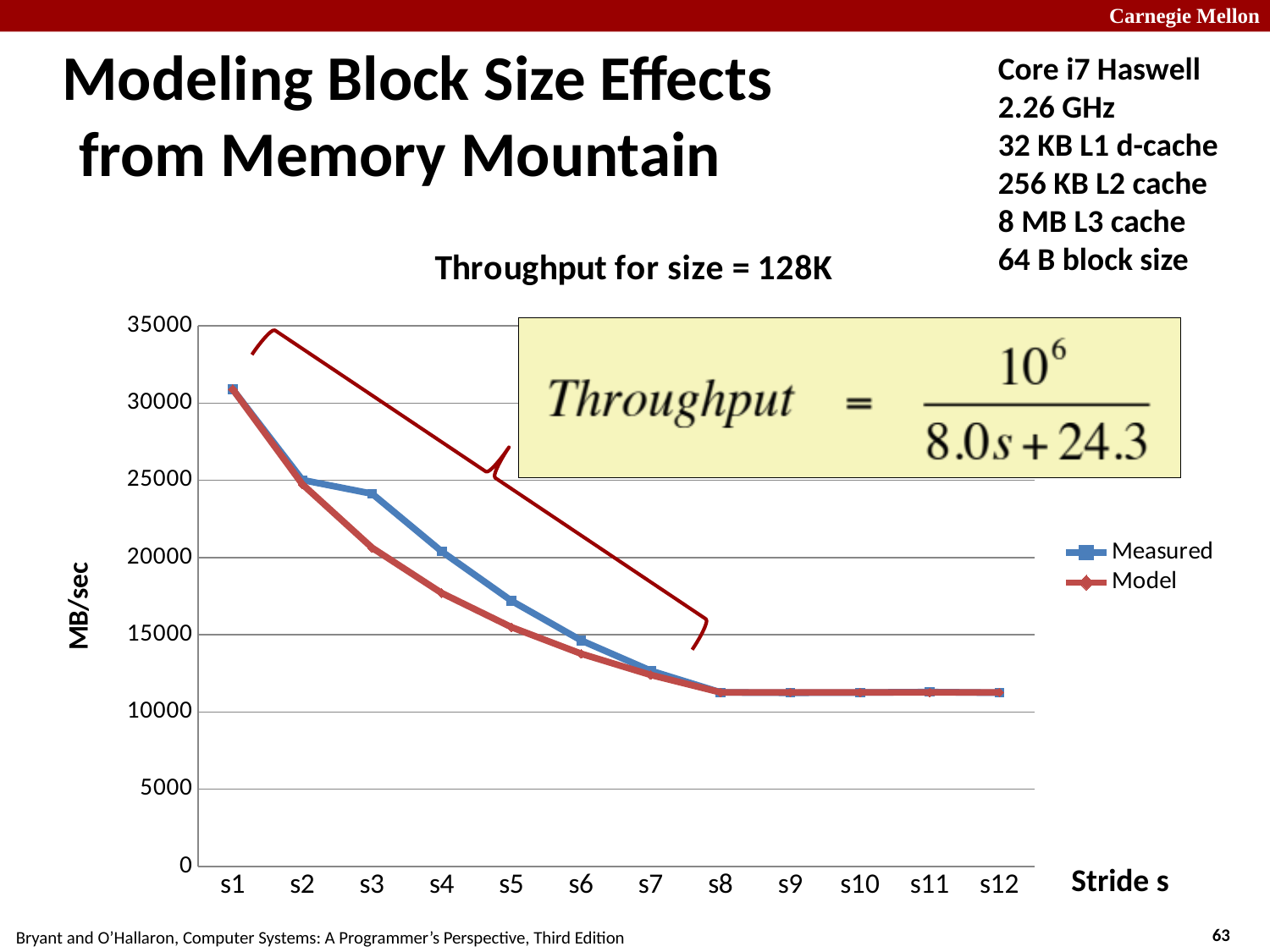
At stride s3, which series has the larger value, Measured or Model? Measured How many stride values are plotted along the x axis? 12 What is the title of the chart? Throughput for size = 128K What are the two series named in the legend? Measured and Model What kind of chart is shown on the slide? line chart How many series does the legend list? 2 Which stride has the highest Measured throughput? s1 Is the Measured value at s1 greater or less than 25000? greater Is the Measured value at s8 greater or less than 15000? less Is the Model value at s4 greater or less than 20000? less Do the Measured values rise or fall as the stride increases from s1 to s12? fall